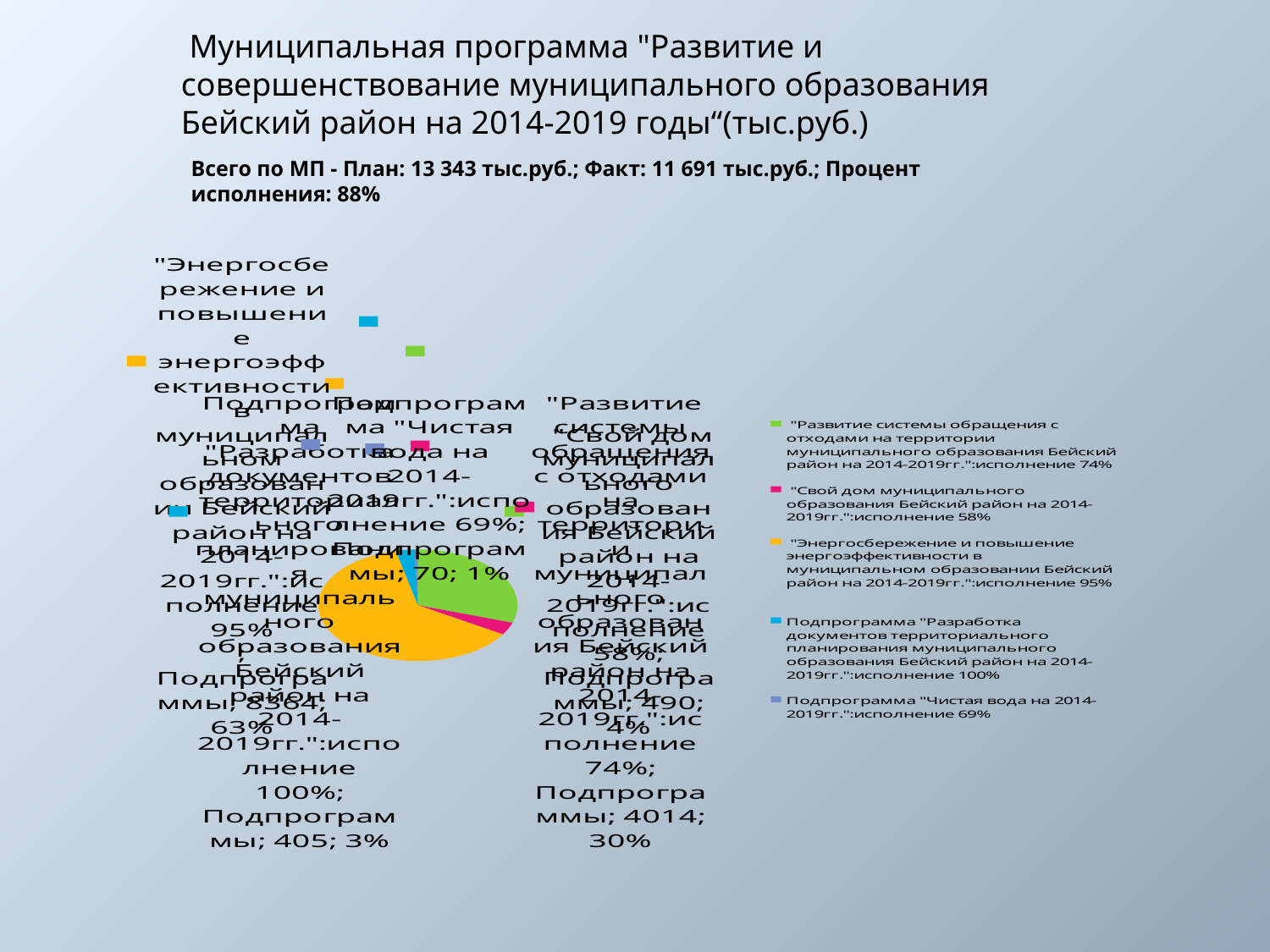
How many slices does the pie chart have? 5 Which is larger: the value for "Свой дом" or the value for Подпрограмма "Разработка документов территориального планирования"? "Свой дом" What share of the pie does the "Развитие системы обращения с отходами" slice represent? 30% Which slice of the pie is the largest? "Энергосбережение и повышение энергоэффективности" What value is shown for the "Развитие системы обращения с отходами" slice? 4014 Which slice of the pie is the smallest? Подпрограмма "Чистая вода на 2014-2019гг." How many entries does the chart legend list? 5 What is the difference between the values for "Энергосбережение и повышение энергоэффективности" (8364) and "Развитие системы обращения с отходами" (4014)? 4350 What value is shown for the Подпрограмма "Чистая вода на 2014-2019гг." slice? 70 What kind of chart is shown on the slide? pie chart What value is shown for the "Энергосбережение и повышение энергоэффективности" slice? 8364 What share of the pie does the "Энергосбережение и повышение энергоэффективности" slice represent? 63%